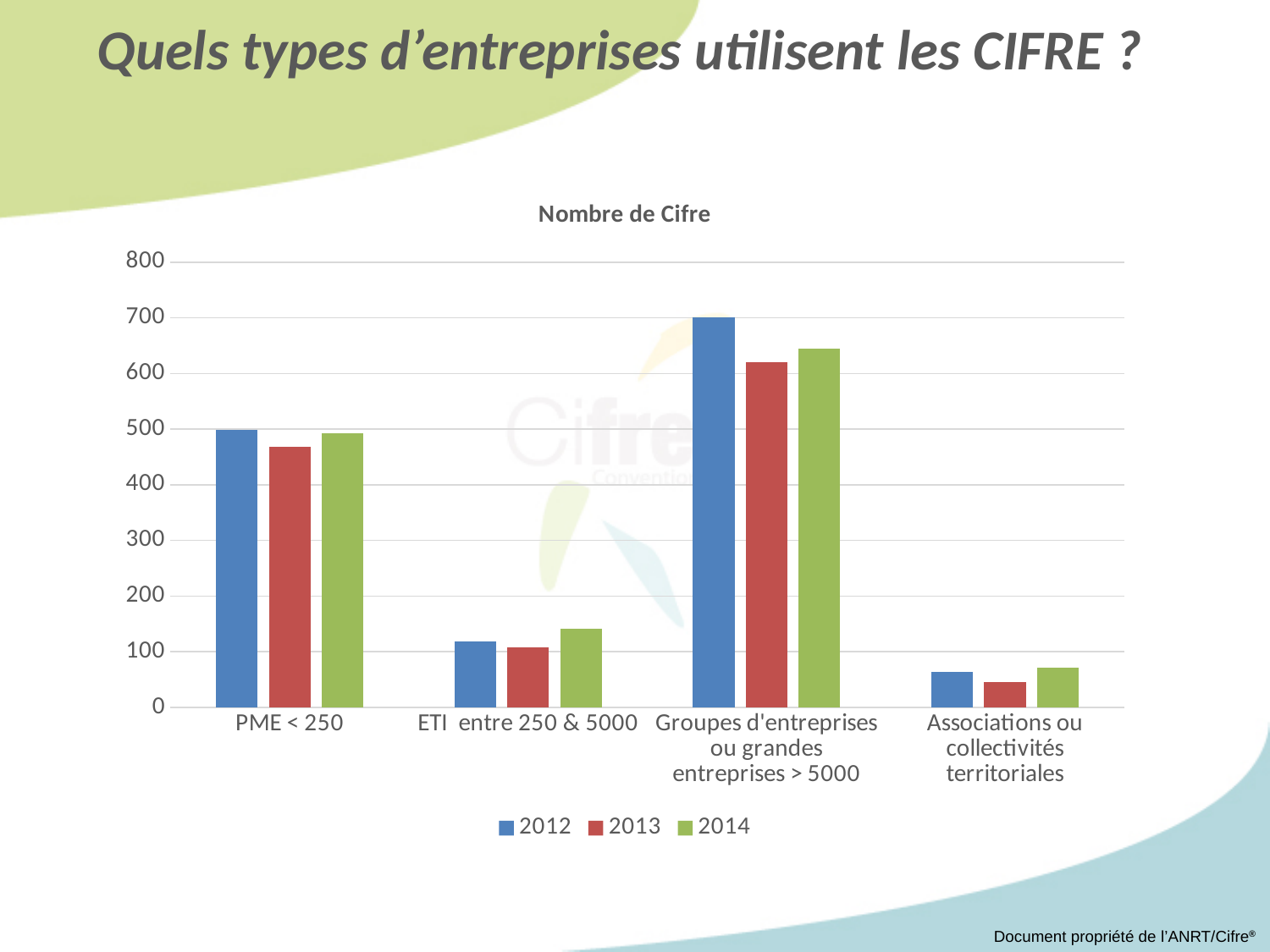
Which category has the lowest value for 2014? Associations ou collectivités territoriales Is the 2014 value for ETI entre 250 & 5000 greater or less than 100? greater Is the 2013 value for Groupes d'entreprises ou grandes entreprises > 5000 greater or less than 600? greater Which category has the highest value for 2012? Groupes d'entreprises ou grandes entreprises > 5000 For PME < 250, which year has the larger value, 2012 or 2013? 2012 Is the 2013 value for PME < 250 greater or less than 500? less How many categories are shown on the x axis? 4 What type of chart is shown on the slide? bar chart For Groupes d'entreprises ou grandes entreprises > 5000, did the value rise or fall from 2012 to 2013? fall How many series does the legend list? 3 What is the title of the chart? Nombre de Cifre